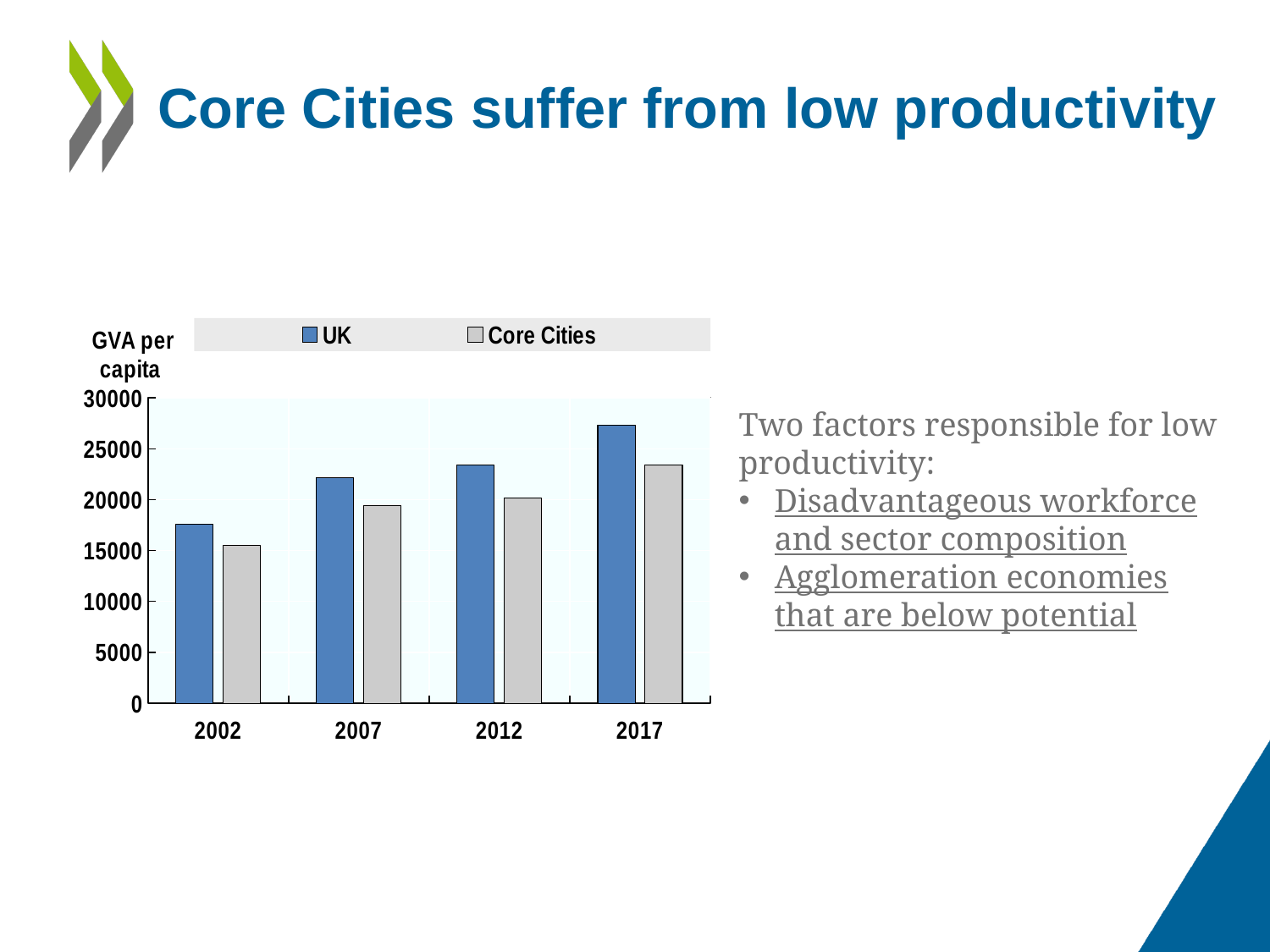
How many series does the legend list? 2 Is the Core Cities value for 2002 greater or less than 20000? less In which year is the UK value highest? 2017 Is the UK value for 2002 greater or less than 20000? less Do the UK values rise or fall from 2002 to 2017? rise What kind of chart is shown on the slide? bar chart Is the Core Cities value for 2017 greater or less than 20000? greater In which year is the Core Cities value lowest? 2002 What is the label on the vertical axis of the chart? GVA per capita In 2017, which is larger: the UK value or the Core Cities value? UK How many years are shown on the x axis? 4